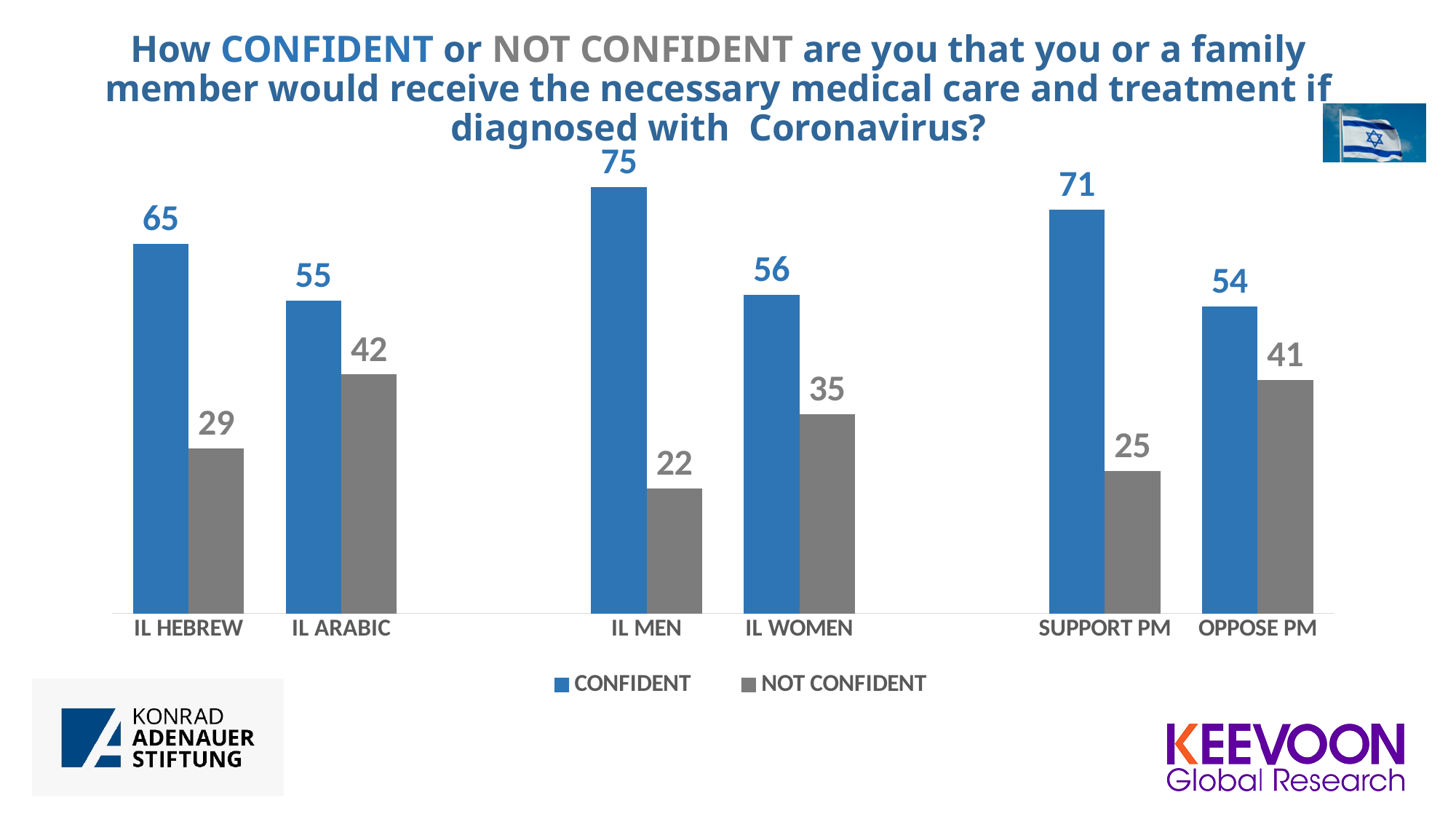
How many categories are shown on the x axis? 6 What is the CONFIDENT value for OPPOSE PM? 54 Which category has the highest CONFIDENT value? IL MEN Which is larger, the NOT CONFIDENT value for IL WOMEN or for OPPOSE PM? OPPOSE PM What is the difference between the CONFIDENT values for IL HEBREW and IL ARABIC? 10 How many series does the legend list? 2 What kind of chart is shown on the slide? Bar chart What is the CONFIDENT value for IL HEBREW? 65 What is the difference between the CONFIDENT and NOT CONFIDENT values for SUPPORT PM? 46 What is the NOT CONFIDENT value for IL ARABIC? 42 What is the NOT CONFIDENT value for IL MEN? 22 Which category has the lowest NOT CONFIDENT value? IL MEN